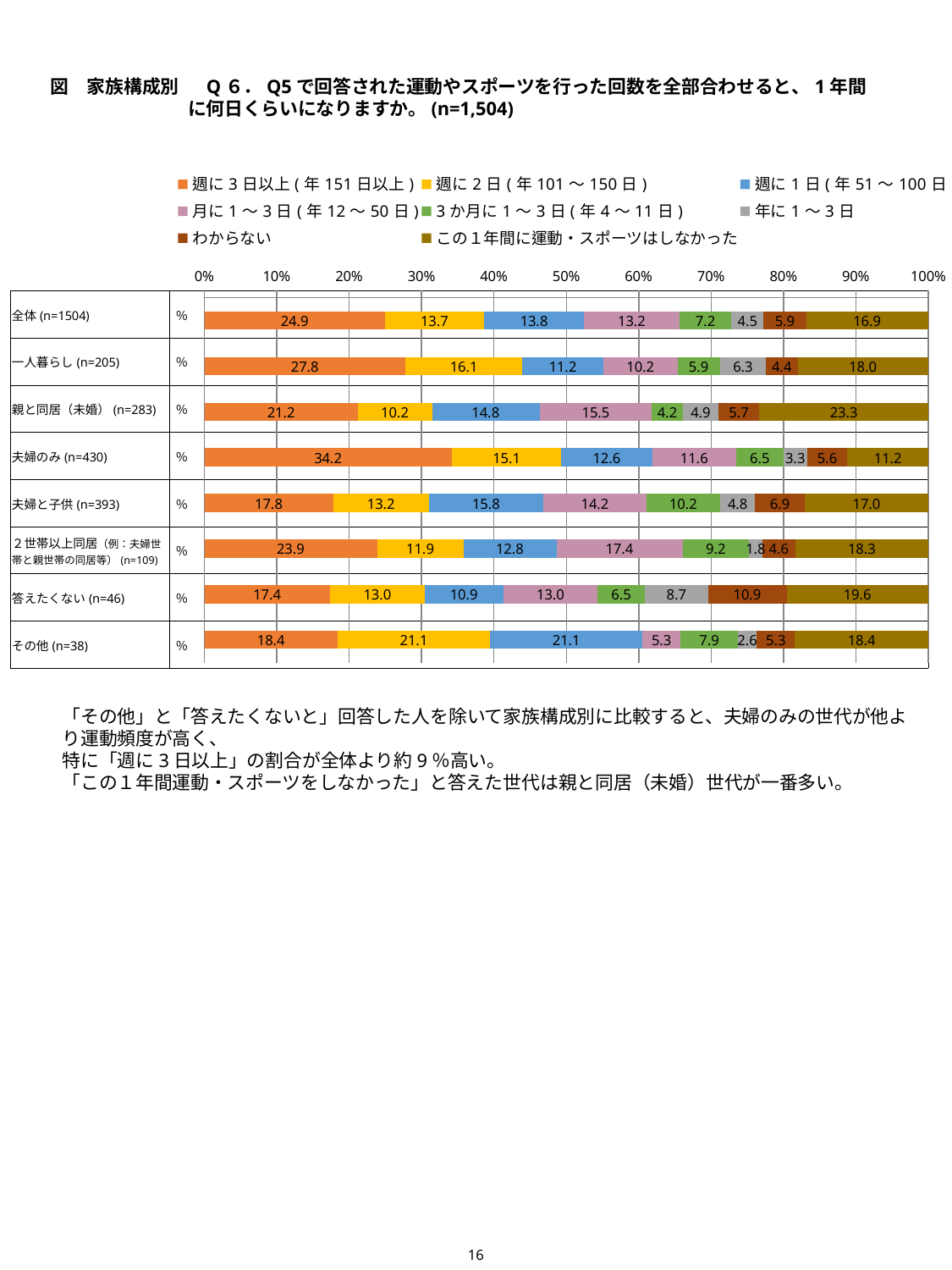
What is the value for 週に2日(年101〜150日) in the その他 (n=38) bar? 21.1 What is the sample size (n) shown for the 一人暮らし category? 205 Which category has the lowest value for この1年間に運動・スポーツはしなかった? 夫婦のみ (n=430) How many series does the legend list? 8 What is the difference between the 週に3日以上(年151日以上) value for 夫婦のみ (n=430) and for 全体 (n=1504)? 9.3 What is the value for 年に1〜3日 in the 2世帯以上同居 (n=109) bar? 1.8 What kind of chart is shown on the slide? Stacked bar chart Which is larger: the わからない value for 答えたくない (n=46) or for 夫婦と子供 (n=393)? 答えたくない (n=46) Which category has the highest value for 週に3日以上(年151日以上)? 夫婦のみ (n=430) How many family-composition categories are shown in the chart? 8 What is the value for この1年間に運動・スポーツはしなかった in the 親と同居（未婚） (n=283) bar? 23.3 What is the value for 週に3日以上(年151日以上) in the 全体 (n=1504) bar? 24.9